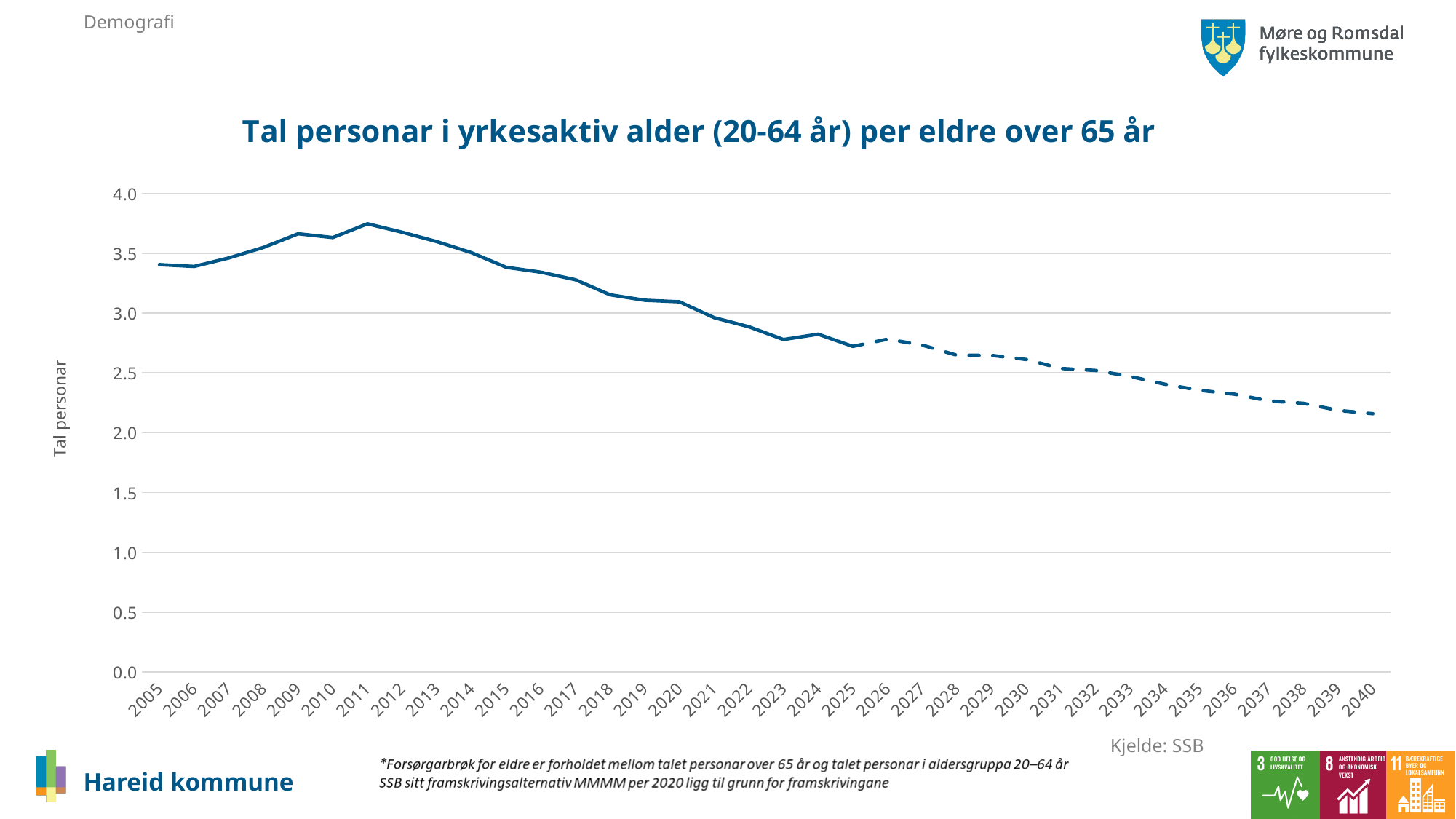
Overall, do the values rise or fall from 2011 to 2040? fall Is the value for 2005 greater or less than 3.0? greater What is the label on the vertical axis of the chart? Tal personar How many years are shown along the x axis of the chart? 36 Is the value for 2011 greater or less than 3.5? greater What kind of chart is shown on the slide? line chart Is the value for 2040 greater or less than 2.5? less In which year does the line reach its highest value? 2011 What is the title of the chart? Tal personar i yrkesaktiv alder (20-64 år) per eldre over 65 år In which year does the line reach its lowest value? 2040 Which year has the larger value, 2009 or 2015? 2009